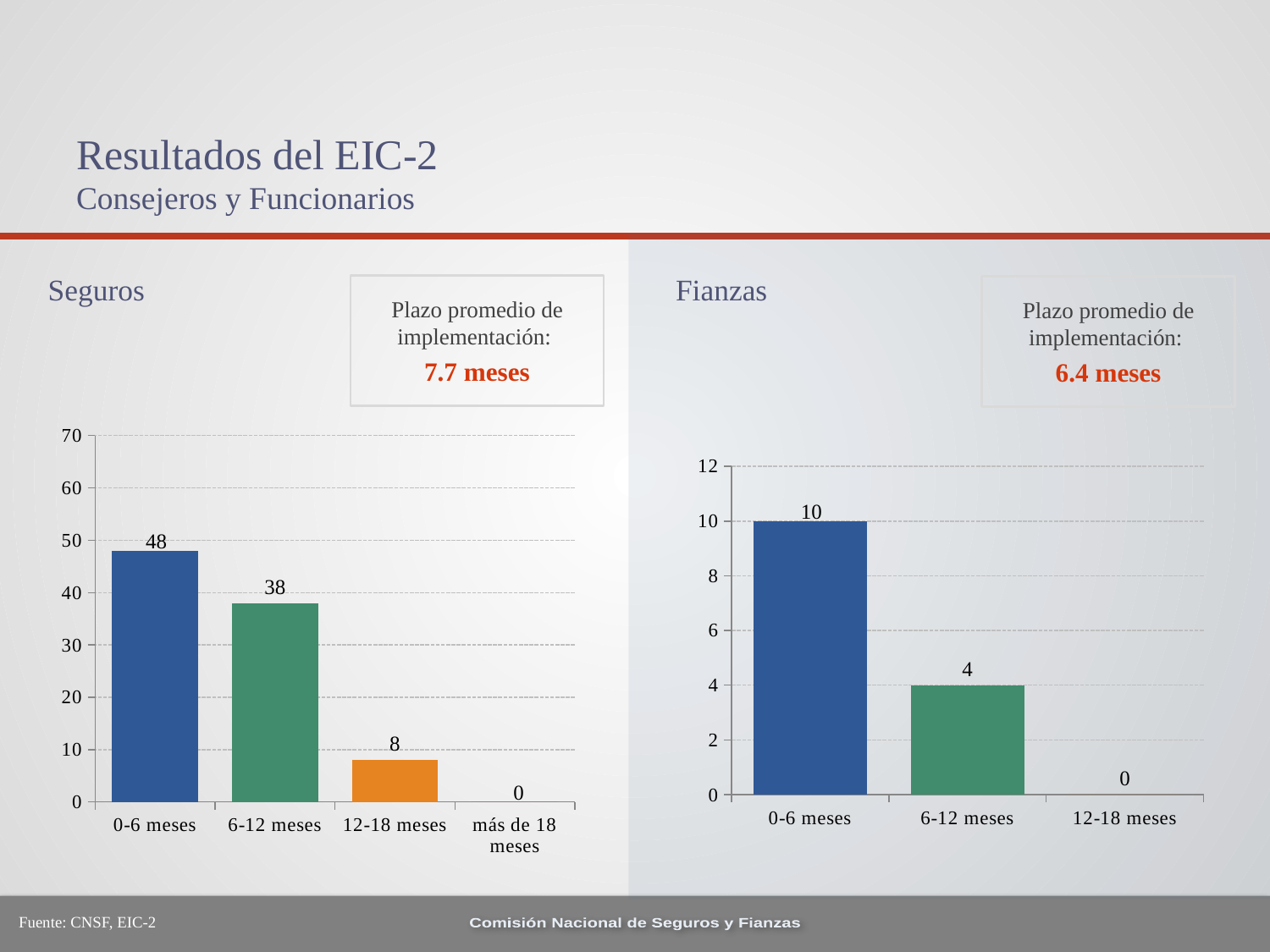
In the Seguros chart, do the values rise or fall from left to right along the x axis? Fall In the Seguros chart, which category has the highest value? 0-6 meses In the Fianzas chart, what is the value for 6-12 meses? 4 What kind of chart is the Fianzas chart? Bar chart How many categories are shown on the x axis of the Fianzas chart? 3 In the Seguros chart, which is larger, the value for 6-12 meses or the value for 12-18 meses? 6-12 meses In the Seguros chart, what is the value for 0-6 meses? 48 In the Fianzas chart, which category has the lowest value? 12-18 meses In the Seguros chart, what is the difference between the values for 0-6 meses and 6-12 meses? 10 In the Seguros chart, what is the value for 12-18 meses? 8 In the Fianzas chart, what is the difference between the values for 0-6 meses and 6-12 meses? 6 How many categories are shown on the x axis of the Seguros chart? 4